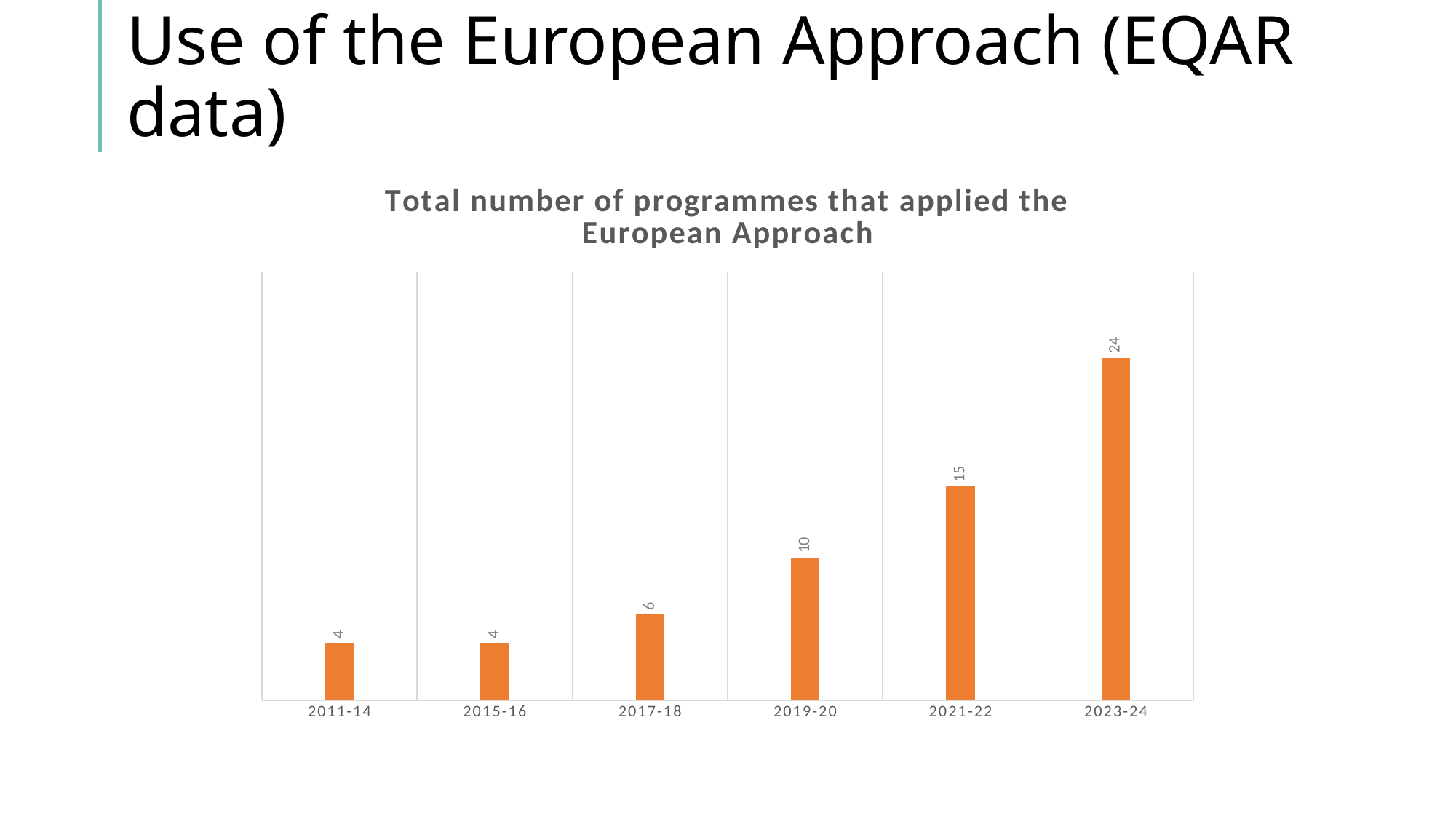
What is the value for 2023-24? 24 How many periods are shown on the x axis? 6 What is the value for 2021-22? 15 What is the difference between the values for 2023-24 and 2021-22? 9 What is the value for 2019-20? 10 What is the difference between the values for 2019-20 and 2011-14? 6 What is the value for 2017-18? 6 What is the title of the chart? Total number of programmes that applied the European Approach Do the values generally rise or fall from 2011-14 to 2023-24? Rise Which period has the highest number of programmes? 2023-24 What kind of chart is shown? Bar chart Which is larger, the value for 2017-18 or the value for 2019-20? 2019-20